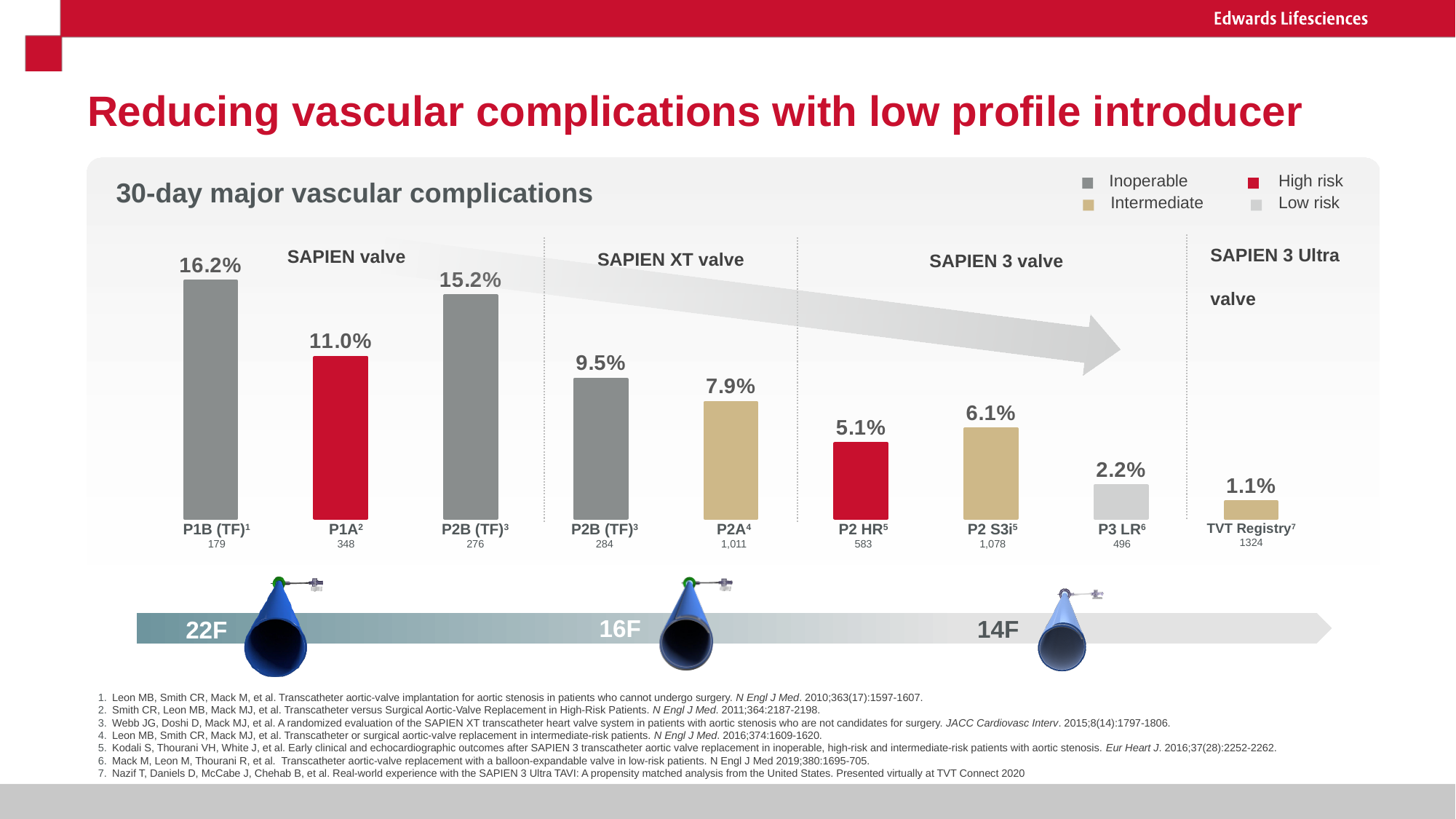
How many bars are plotted in the chart? 9 What is the difference between the P1B (TF) value and the P1A value? 5.2% What is the value for P2B (TF) in the SAPIEN XT valve group? 9.5% What is the difference between the P2 S3i value and the P2 HR value? 1.0% What is the value shown for the TVT Registry bar under SAPIEN 3 Ultra valve? 1.1% How many risk categories does the legend list? 4 What type of chart is shown on the slide? Bar chart Which bar has the lowest 30-day major vascular complication rate? TVT Registry Which bar has the highest 30-day major vascular complication rate? P1B (TF) What is the value shown for P3 LR? 2.2% Which is larger, the value for P2A or the value for P2 S3i? P2A What is the 30-day major vascular complication rate for P1A? 11.0%